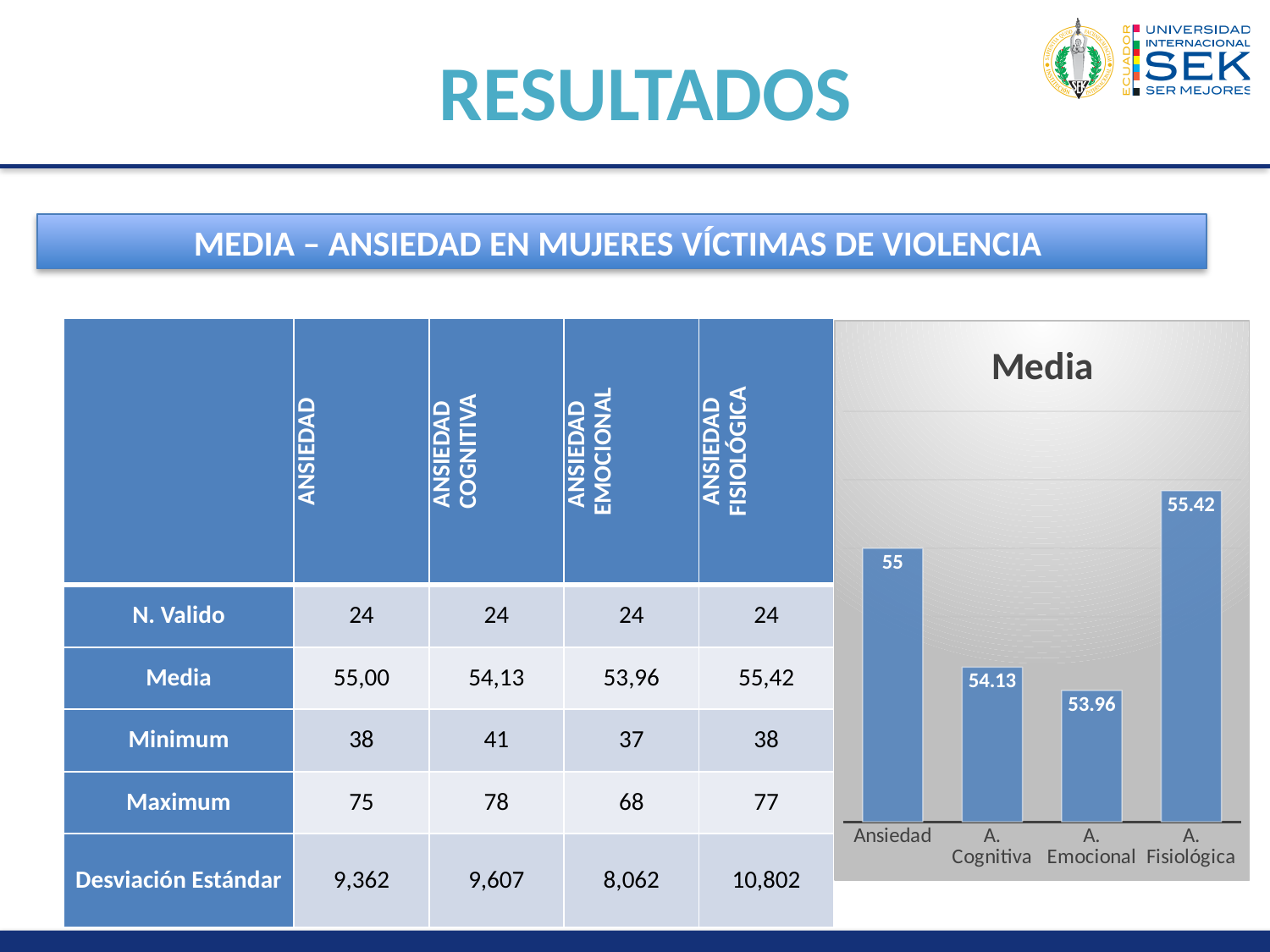
What is the difference between the A. Fisiológica and A. Emocional values in the Media chart? 1.46 What is the difference between the A. Fisiológica and Ansiedad values in the Media chart? 0.42 What kind of chart is shown on the slide? Bar chart What is the title of the chart on the slide? Media What is the value shown for A. Fisiológica in the Media chart? 55.42 Which category has the lowest value in the Media chart? A. Emocional What is the value shown for A. Emocional in the Media chart? 53.96 In the Media chart, which is larger: A. Cognitiva or A. Emocional? A. Cognitiva What is the value shown for A. Cognitiva in the Media chart? 54.13 How many categories are plotted in the Media chart? 4 Which category has the highest value in the Media chart? A. Fisiológica What is the value of the Ansiedad bar in the Media chart? 55